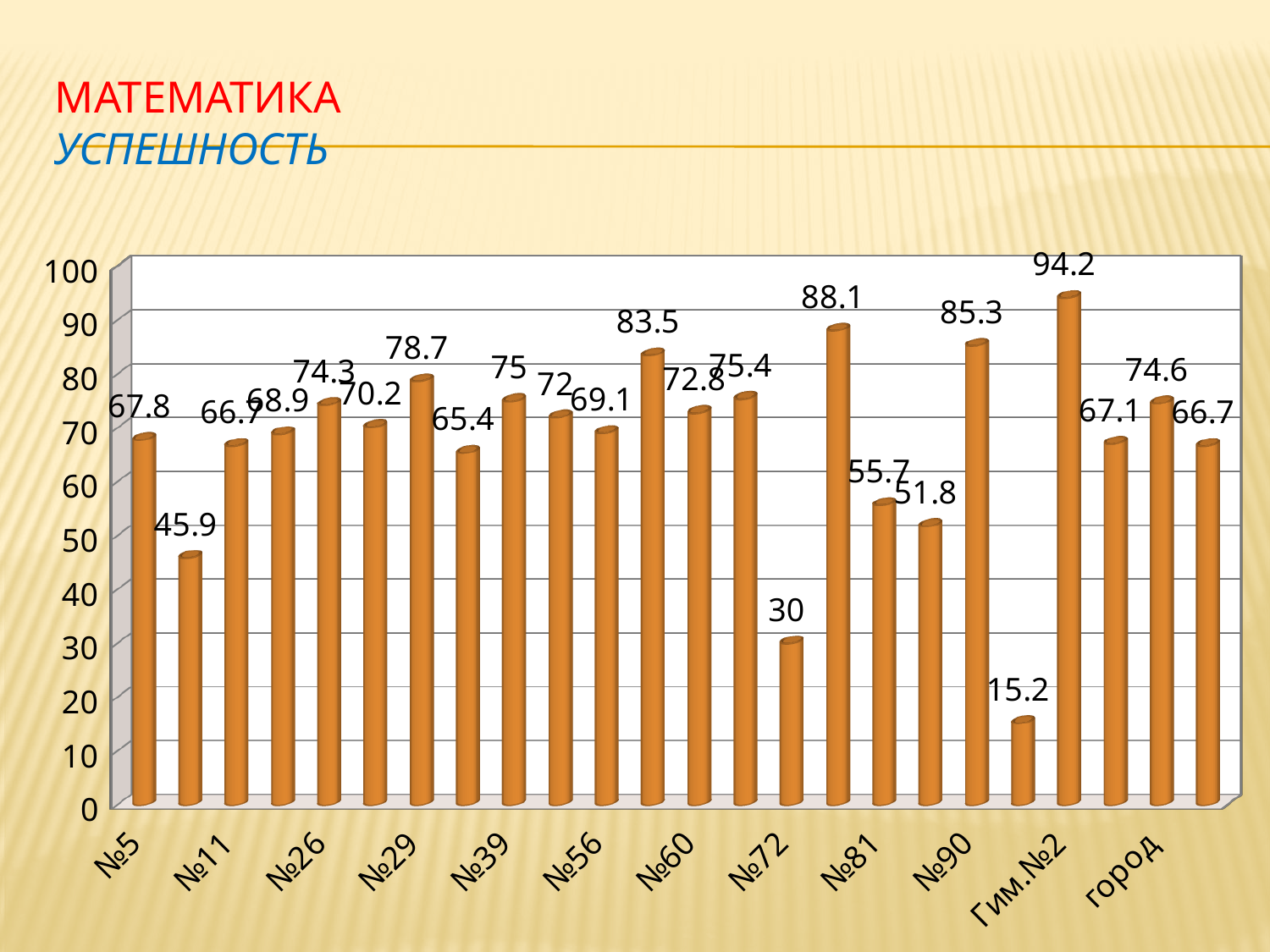
Which is larger: the value 88.1 or the value 85.3? 88.1 Is the value of the bar labelled №72 greater or less than 40? less What is the difference between the highest value (94.2) and the lowest value (15.2) in the chart? 79 What subject is named in the slide title above the chart? МАТЕМАТИКА What is the value of the bar labelled №72? 30 How many bars are plotted in the chart? 24 What is the value of the bar labelled Гим.№2? 94.2 What is the highest value shown in the chart? 94.2 What is the maximum value shown on the vertical axis? 100 What type of chart is shown on the slide? bar chart What is the lowest value shown in the chart? 15.2 What is the value of the first bar, labelled №5? 67.8